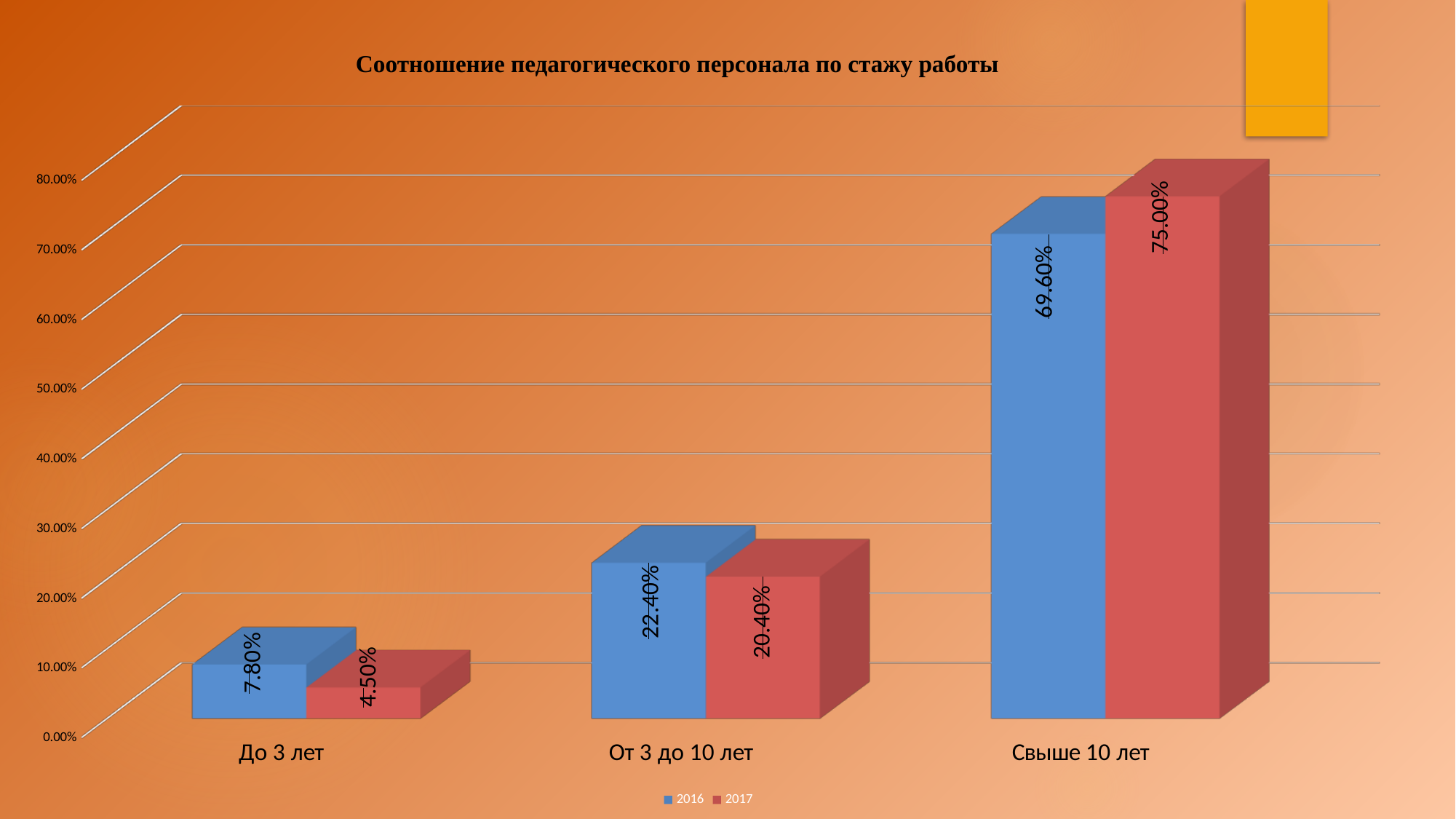
What is the value for 2017 in the category "Свыше 10 лет"? 75.00% How many series does the legend list? 2 Which is larger for "От 3 до 10 лет": the 2016 value or the 2017 value? 2016 What is the value for 2016 in the category "До 3 лет"? 7.80% How many categories are shown on the x axis? 3 What is the difference between the 2017 and 2016 values for "Свыше 10 лет"? 5.40% What is the difference between the 2016 and 2017 values for "До 3 лет"? 3.30% What kind of chart is shown on the slide? Bar chart Which category has the lowest value for 2017? До 3 лет What is the value for 2017 in the category "От 3 до 10 лет"? 20.40% Which category has the highest value for 2016? Свыше 10 лет What is the title of the chart? Соотношение педагогического персонала по стажу работы